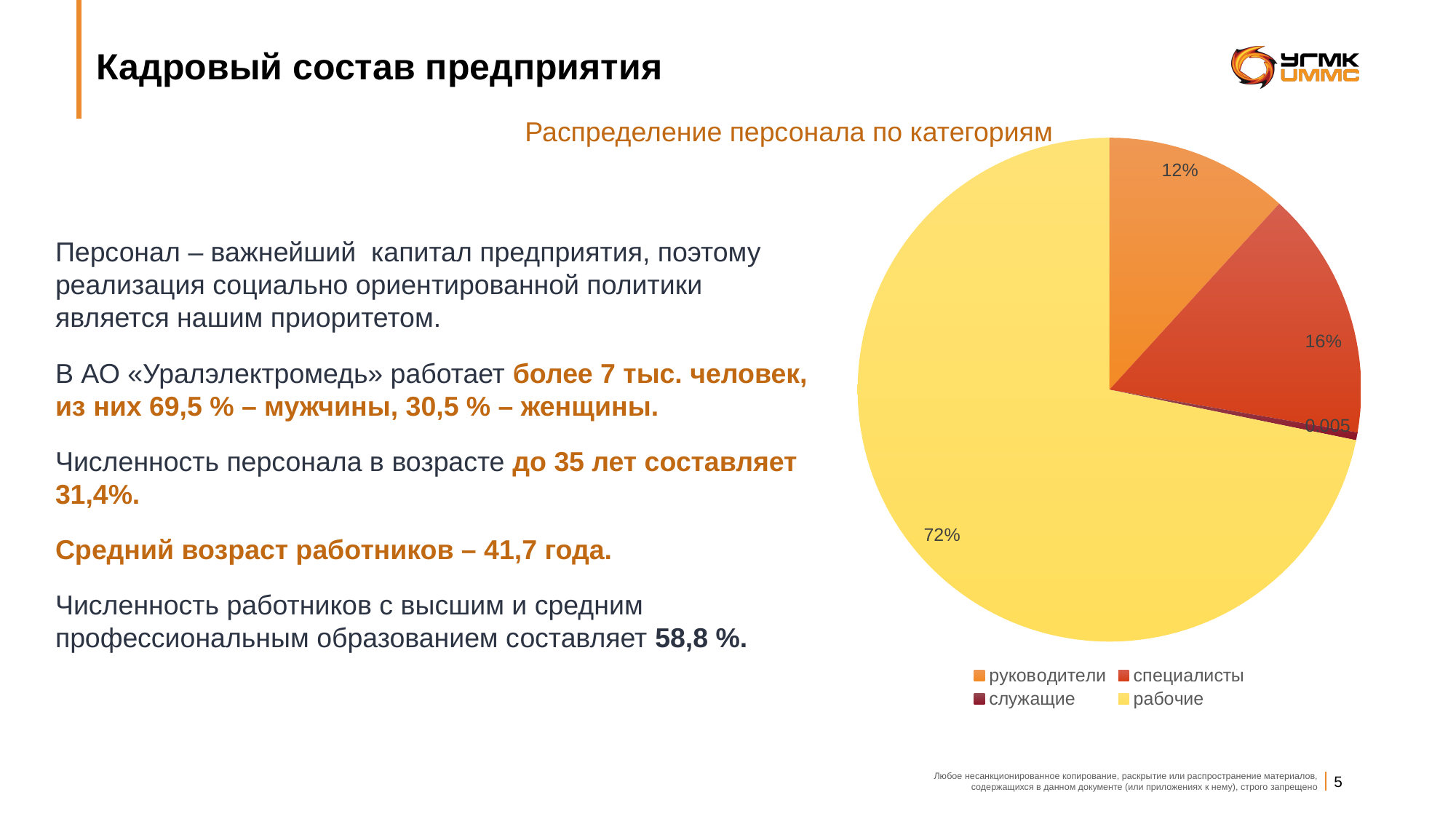
Which slice is larger, руководители or специалисты? специалисты What is the difference in percentage points between the рабочие slice and the специалисты slice? 56 What share of the pie does the руководители slice have? 12% Which legend entry is shown in yellow? рабочие What share of the pie does the рабочие slice have? 72% What is the title of the chart? Распределение персонала по категориям How many categories does the legend of the pie chart list? 4 What kind of chart is shown on the slide? pie chart What is the difference in percentage points between the специалисты slice and the руководители slice? 4 What share of the pie does the специалисты slice have? 16% Which category has the smallest slice of the pie? служащие Which category has the largest slice of the pie? рабочие